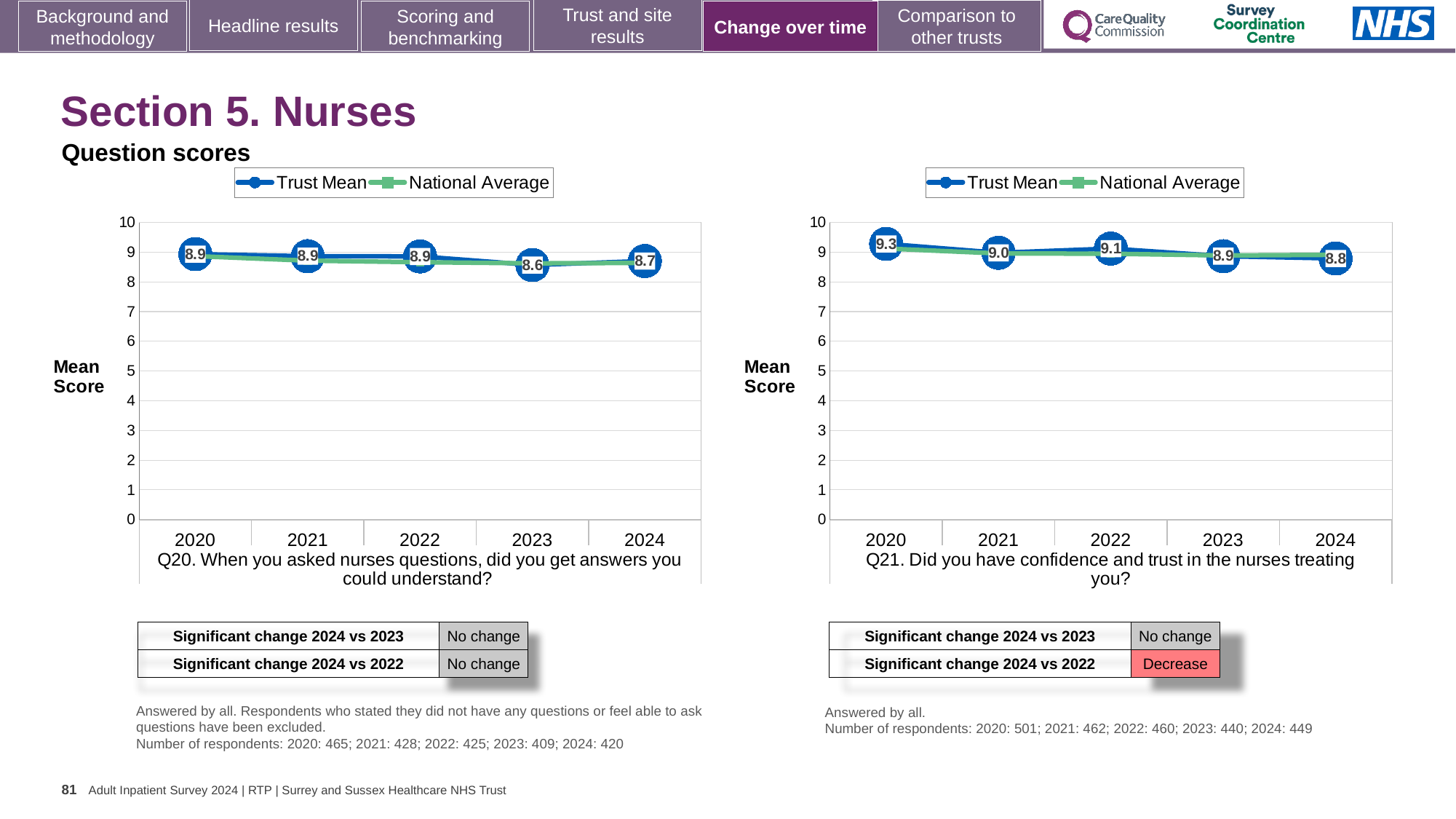
On the Q21 chart (right), does the Trust Mean score generally rise or fall from 2020 to 2024? Fall On the Q20 chart (left), what is the Trust Mean score for 2023? 8.6 On the Q20 chart (left), what is the Trust Mean score for 2024? 8.7 On the Q21 chart (right), what is the Trust Mean score for 2020? 9.3 How many years are plotted on the Q20 chart (left)? 5 On the Q21 chart (right), what is the Trust Mean score for 2022? 9.1 On the Q21 chart (right), what is the difference between the Trust Mean score in 2020 and in 2024? 0.5 On the Q20 chart (left), which year has the lowest Trust Mean score? 2023 Which is larger: the 2024 Trust Mean on the Q20 chart (left) or the 2024 Trust Mean on the Q21 chart (right)? Q21 chart (8.8) On the Q21 chart (right), which year has the highest Trust Mean score? 2020 What type of chart is used for Q20 (left)? Line chart How many series does the legend of the Q21 chart (right) list? 2